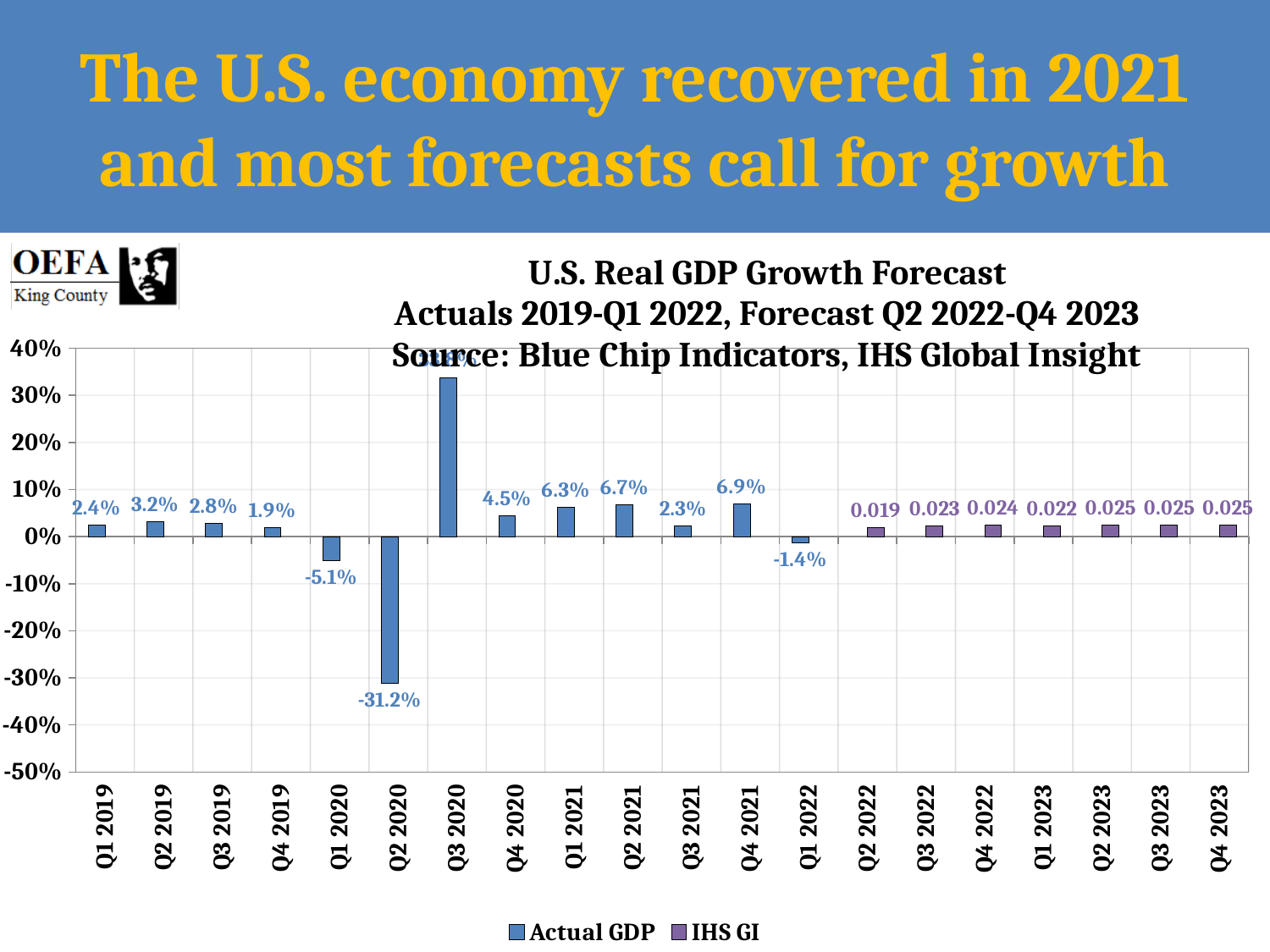
What is the Actual GDP value for Q2 2020? -31.2% Is the value for Q3 2020 greater or less than 30%? greater What is the Actual GDP value for Q1 2022? -1.4% What is the difference between the Actual GDP values for Q4 2021 and Q3 2021? 4.6 percentage points Which quarter has the highest value on the chart? Q3 2020 How many series does the legend list? 2 Which is larger, the Actual GDP value for Q2 2019 or for Q3 2019? Q2 2019 What is the Actual GDP value for Q4 2021? 6.9% How many quarters are shown on the x axis? 20 What is the IHS GI forecast value for Q4 2022? 0.024 What kind of chart is shown on the slide? Bar chart Which quarter has the lowest value on the chart? Q2 2020